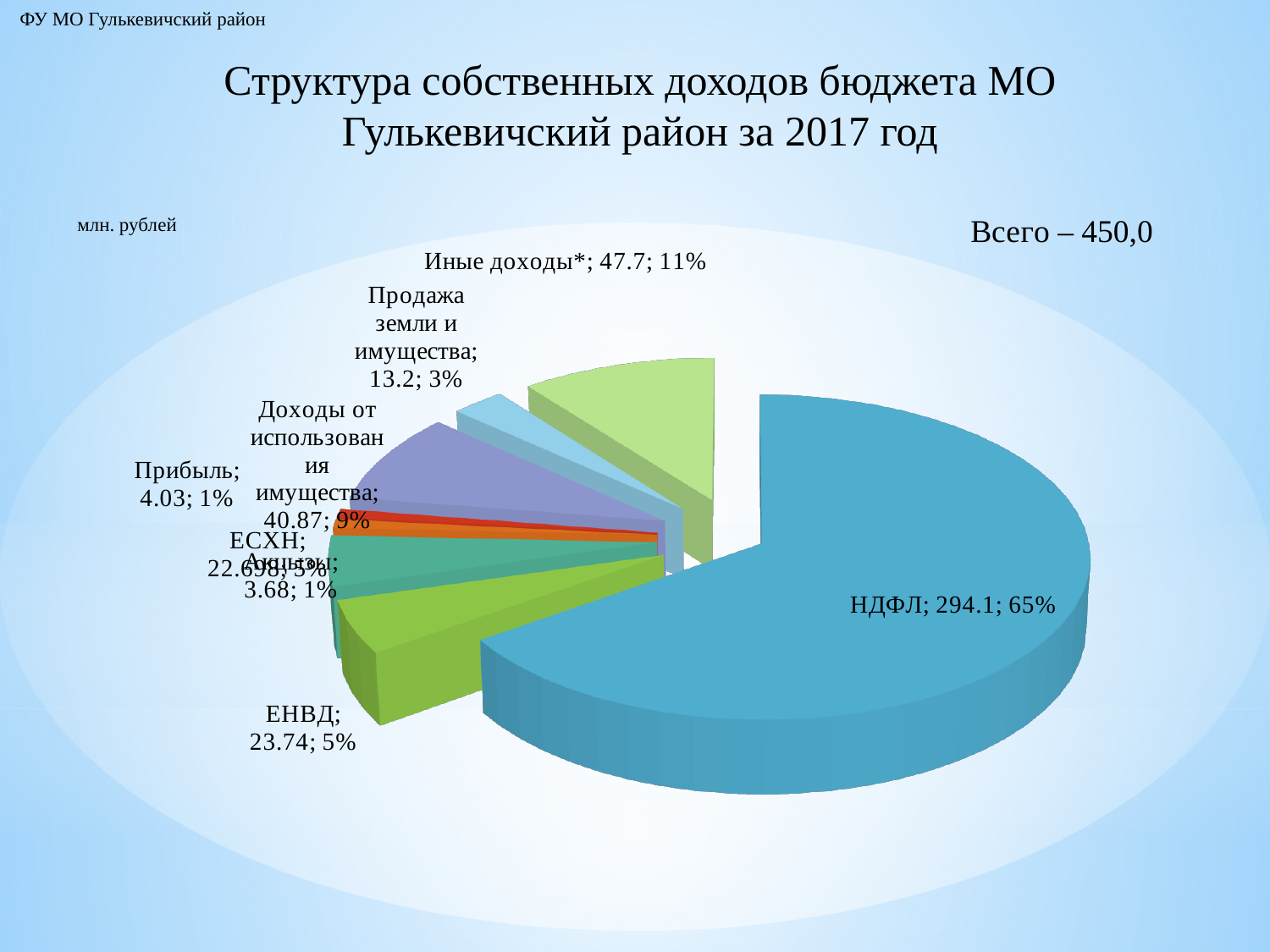
Which is larger, the value for ЕНВД or the value for Доходы от использования имущества? Доходы от использования имущества What is the value for НДФЛ? 294.1 What is the value for Доходы от использования имущества? 40.87 Which category has the largest slice? НДФЛ What share of the pie does НДФЛ account for? 65% What share of the pie does Продажа земли и имущества account for? 3% How many slices does the pie chart have? 8 What is the value for Иные доходы*? 47.7 What total (Всего) is stated on the slide? 450,0 What is the difference between the values for НДФЛ and Иные доходы*? 246.4 What kind of chart is shown on the slide? pie chart Which category has the smallest value? Акцызы